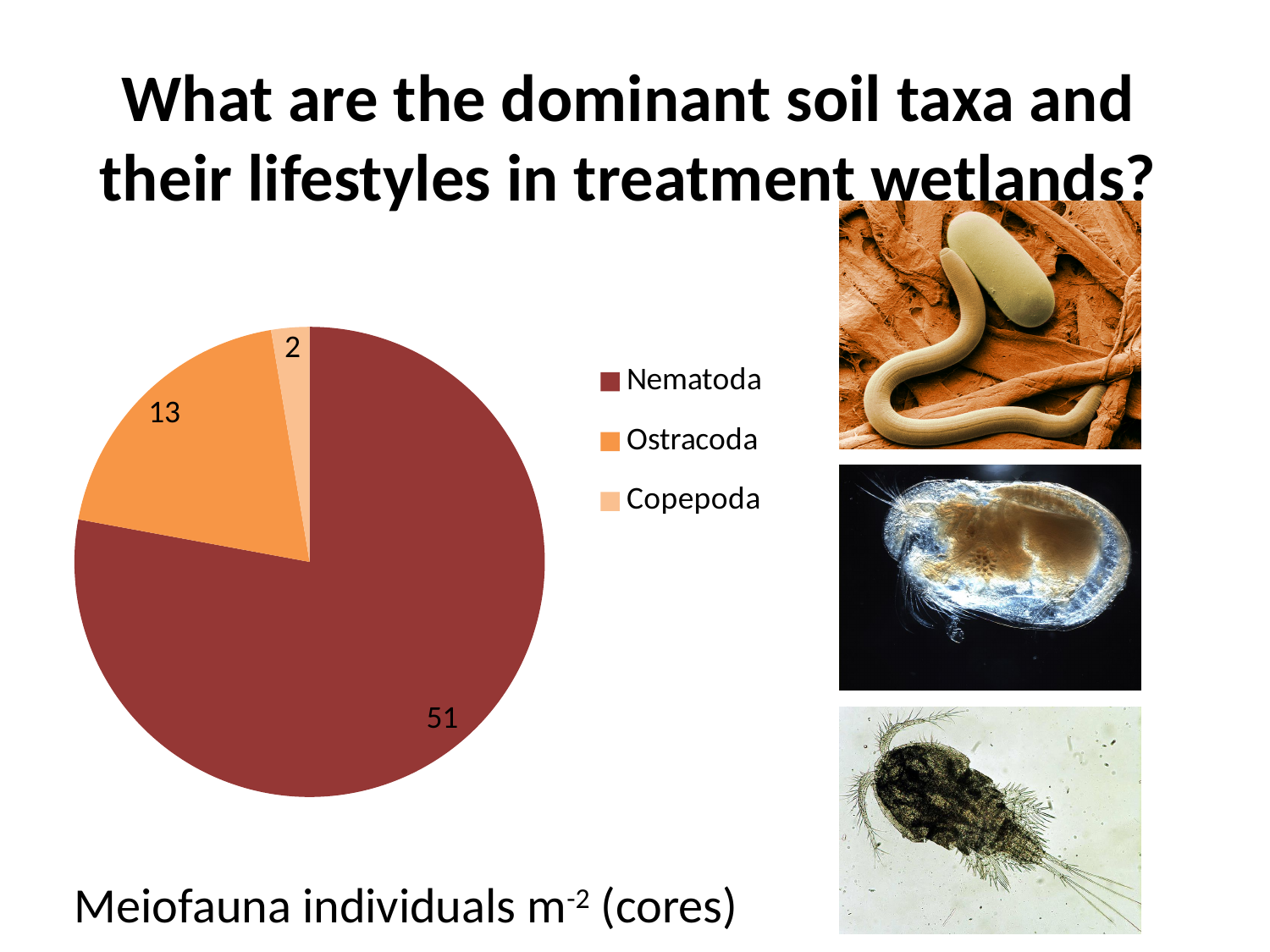
What is the value for Nematoda in the pie chart? 51 What is the total of all the values shown in the pie chart? 66 Which taxon has the largest slice in the pie chart? Nematoda How many slices does the pie chart have? 3 What is the value for Ostracoda in the pie chart? 13 Which is larger, the value for Ostracoda or the value for Copepoda? Ostracoda What is the value for Copepoda in the pie chart? 2 What is the difference between the values for Ostracoda and Copepoda? 11 Which taxon has the smallest slice in the pie chart? Copepoda What type of chart is shown on the slide? pie chart What colour is the Nematoda slice in the pie chart? dark red What is the difference between the values for Nematoda and Ostracoda? 38